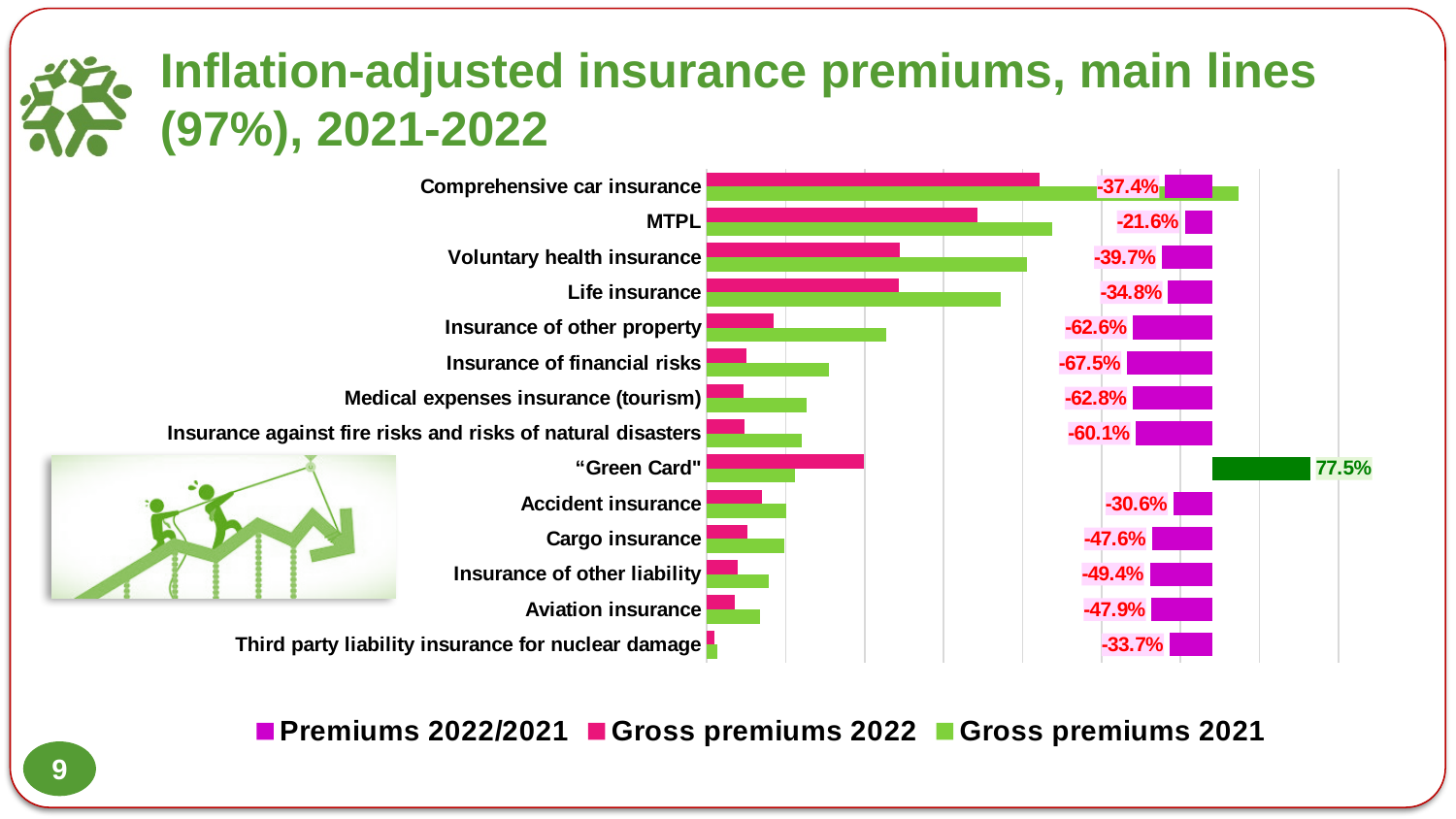
What is the Premiums 2022/2021 value for Insurance of financial risks? -67.5% What is the Premiums 2022/2021 value for MTPL? -21.6% What is the Premiums 2022/2021 value for "Green Card"? 77.5% What is the Premiums 2022/2021 value for Third party liability insurance for nuclear damage? -33.7% Which insurance line has the lowest Premiums 2022/2021 value? Insurance of financial risks How many series does the legend list? 3 Which insurance line has the highest Premiums 2022/2021 value? "Green Card" What kind of chart is shown on the slide? Bar chart What colour represents the Premiums 2022/2021 series in the legend? Purple What is the difference in percentage points between the Premiums 2022/2021 values for MTPL and Comprehensive car insurance? 15.8 percentage points How many insurance lines are shown on the chart? 14 Which has a higher Premiums 2022/2021 value, Accident insurance or Cargo insurance? Accident insurance